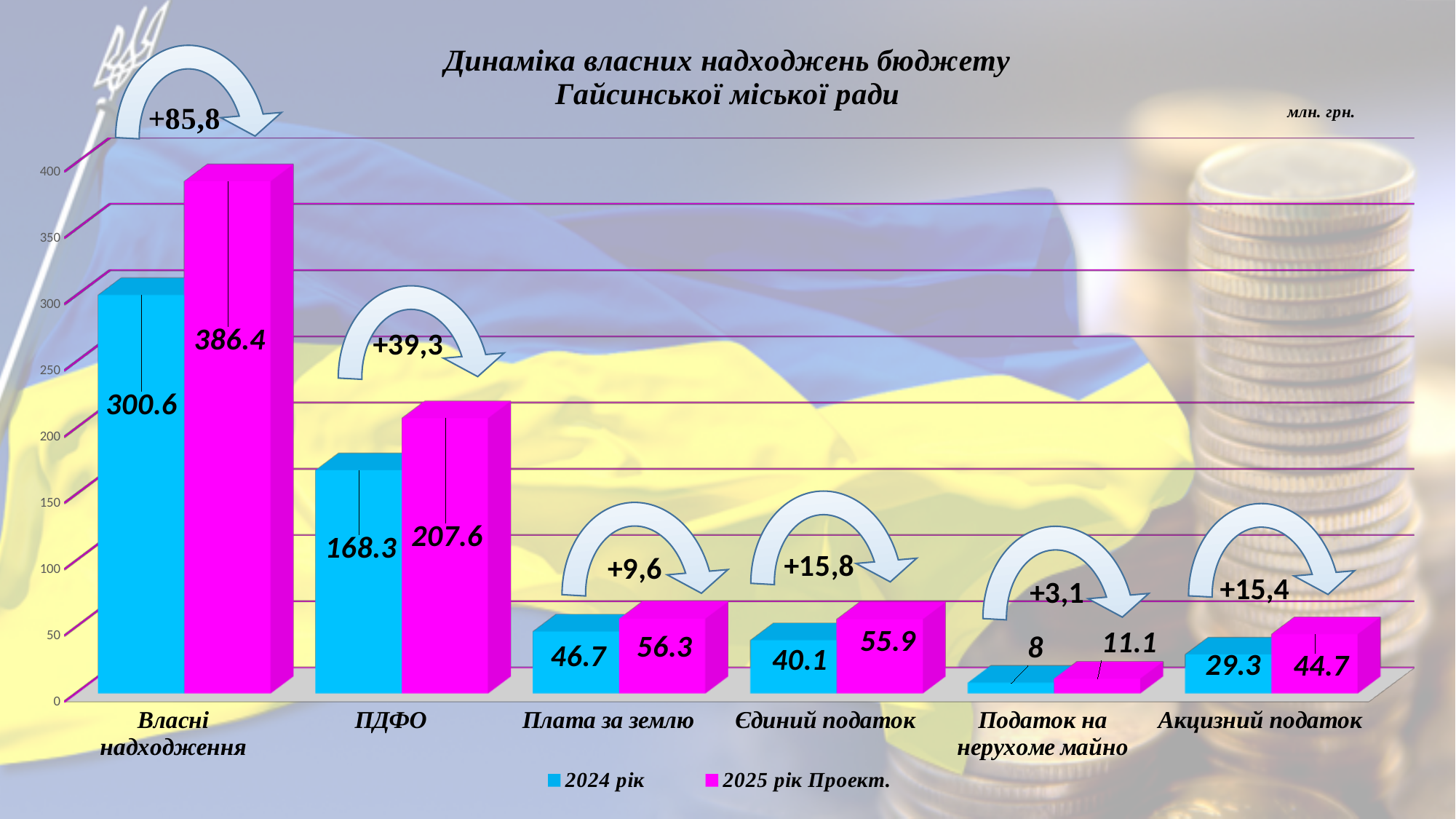
How many categories are shown on the x axis? 6 What is the value for Акцизний податок in the 2025 рік Проект. series? 44.7 Is the 2025 рік Проект. value for ПДФО greater or less than 200? greater What unit is indicated for the values on the chart? млн. грн. What is the value for Податок на нерухоме майно in the 2024 рік series? 8 Which category has the lowest value in the 2024 рік series? Податок на нерухоме майно What is the value for ПДФО in the 2024 рік series? 168.3 How many series does the legend list? 2 What is the difference between the 2025 рік Проект. and 2024 рік values for Єдиний податок? 15.8 Which is larger: the 2024 рік value for Плата за землю or the 2024 рік value for Єдиний податок? Плата за землю Which category has the highest value in the 2025 рік Проект. series? Власні надходження What kind of chart is shown on the slide? bar chart